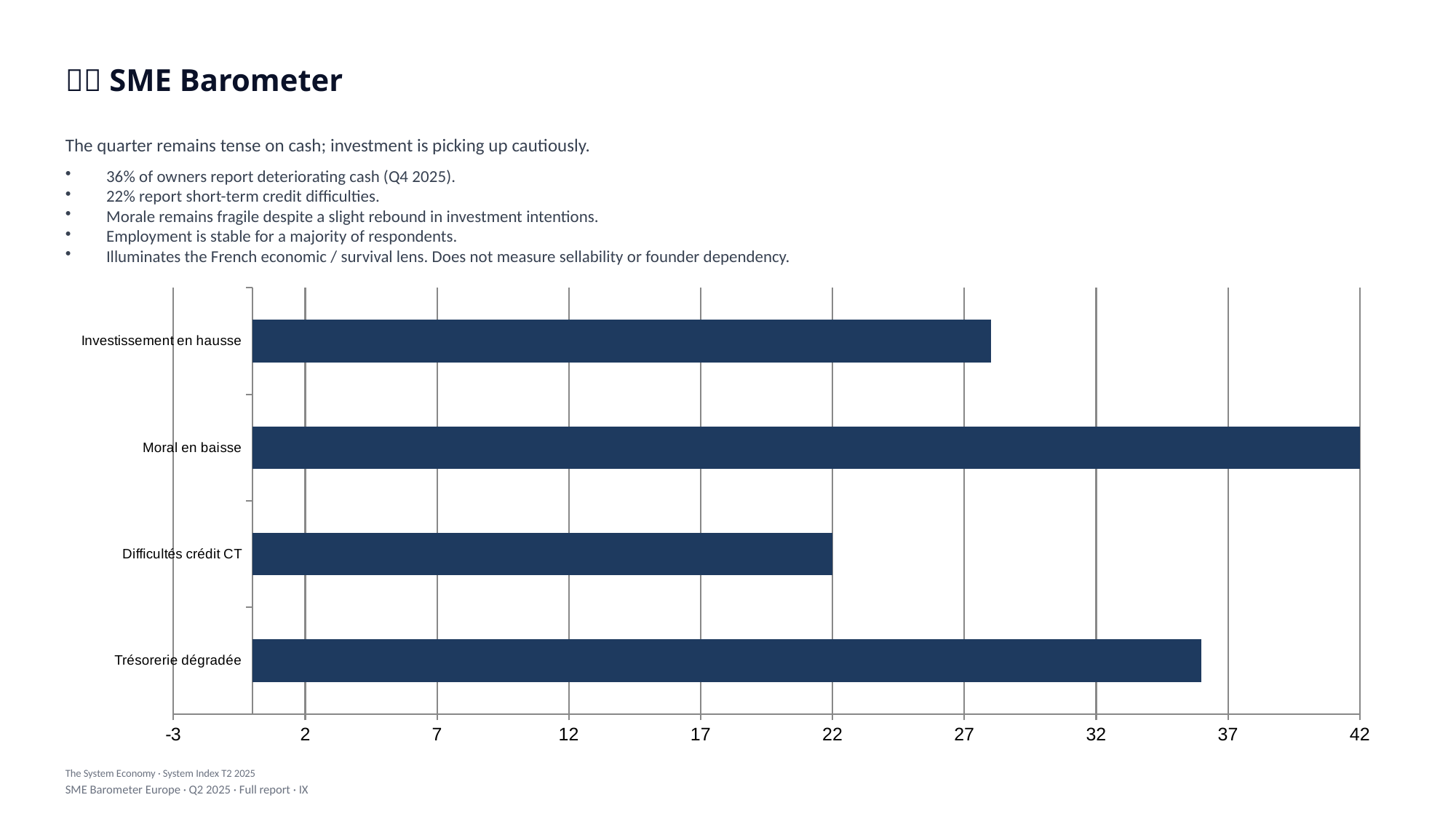
What is the value for Difficultés crédit CT? 22 What kind of chart is shown on the slide? bar chart How many categories are plotted in the chart? 4 Which is larger, the value for Trésorerie dégradée or the value for Investissement en hausse? Trésorerie dégradée What is the difference between the values for Moral en baisse and Difficultés crédit CT? 20 What is the label of the bottom-most category on the chart? Trésorerie dégradée Which category has the highest value in the chart? Moral en baisse Is the value for Trésorerie dégradée greater or less than 37? less Is the value for Trésorerie dégradée greater or less than 32? greater What is the value for Moral en baisse? 42 Is the value for Investissement en hausse greater or less than 32? less Which category has the lowest value in the chart? Difficultés crédit CT